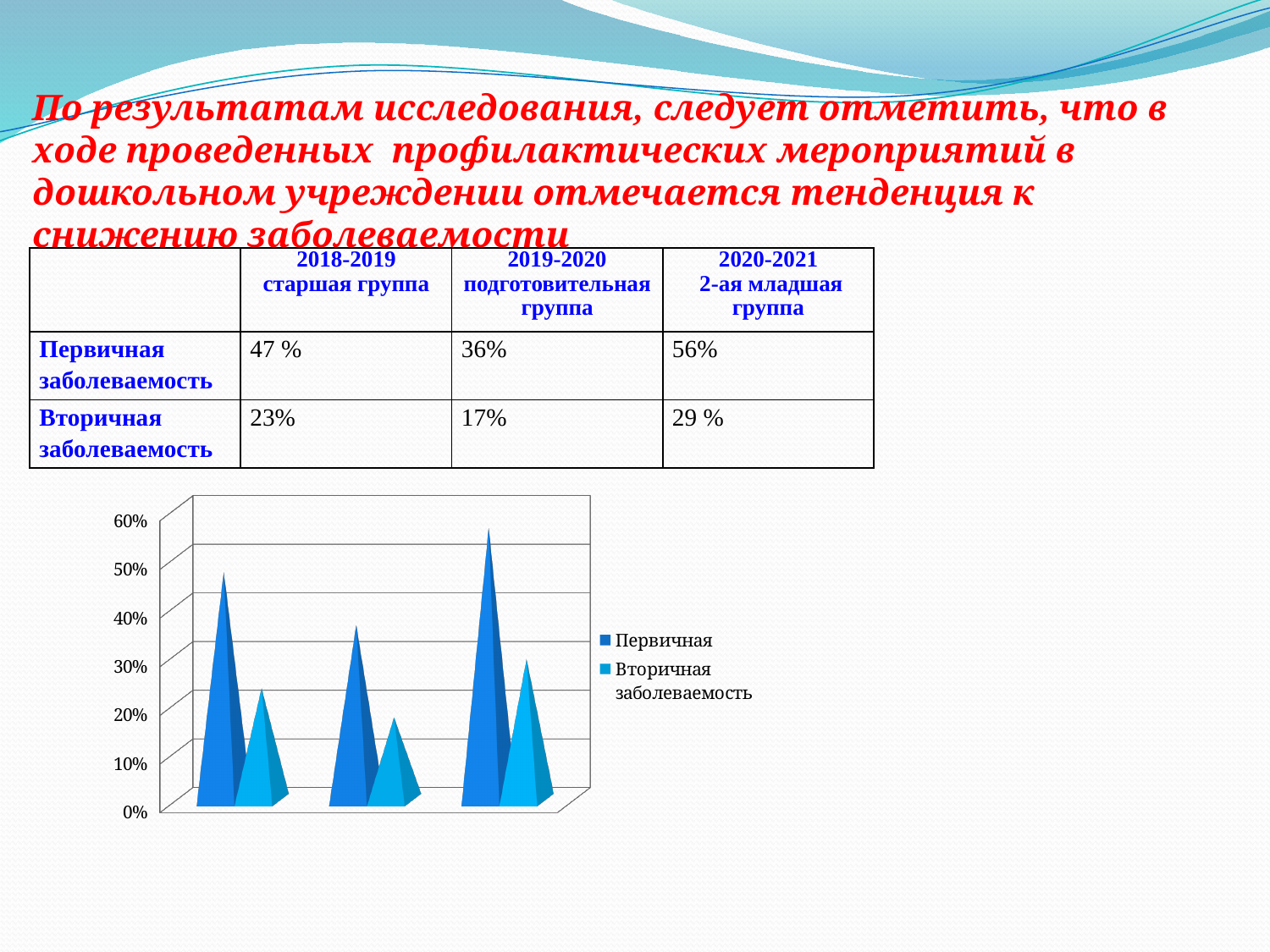
Which group of bars (first, second or third from the left) has the shortest Первичная bar? second Is the Первичная bar in the second group from the left greater or less than 40%? less Which group of bars (first, second or third from the left) has the tallest Первичная bar? third Which series names appear in the chart legend? Первичная; Вторичная заболеваемость Is the Первичная bar in the third group from the left greater or less than 50%? greater How many series does the chart legend list? 2 How many groups of bars are plotted in the chart? 3 What is the highest value shown on the chart's vertical axis? 60% Is the Вторичная заболеваемость bar in the second group from the left greater or less than 20%? less What kind of chart is shown on the slide? bar chart Which group of bars (first, second or third from the left) has the shortest Вторичная заболеваемость bar? second